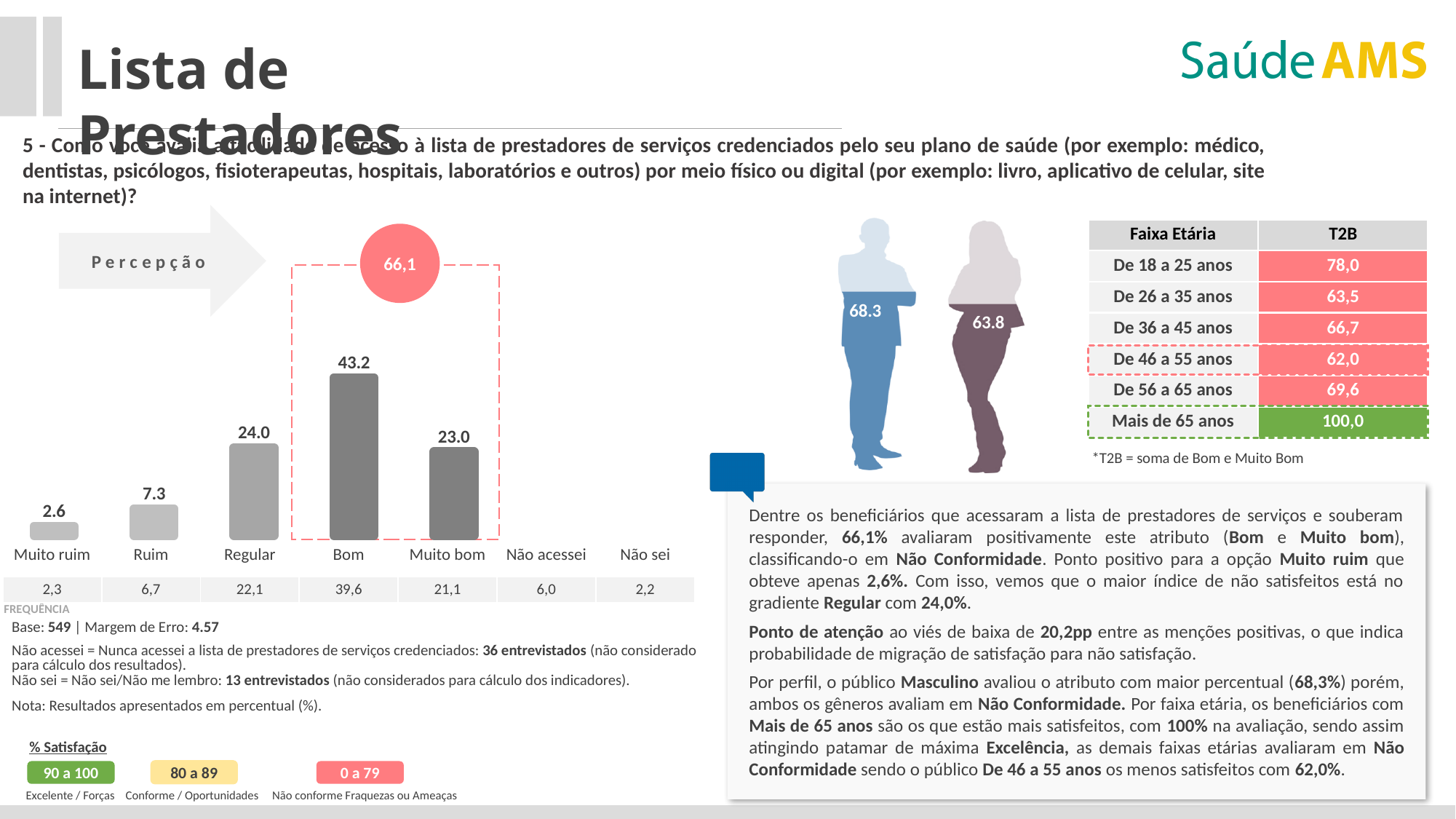
In the Percepção bar chart, what is the value for Bom? 43.2 In the Percepção bar chart, how many categories have a bar plotted? 5 In the Percepção bar chart, which category has the highest value? Bom In the Percepção bar chart, what is the value for Muito ruim? 2.6 In the Percepção bar chart, what is the value for Ruim? 7.3 What value is shown in the pink circle above the dashed box around Bom and Muito bom in the Percepção chart? 66,1 What kind of chart is used to show the Percepção results? bar chart In the Percepção bar chart, what is the difference between the values for Bom and Muito bom? 20.2 In the Percepção bar chart, what is the value for Regular? 24.0 In the Percepção bar chart, which category has the lowest plotted value? Muito ruim In the Percepção bar chart, do the values rise or fall from Muito ruim to Bom? rise In the Percepção bar chart, which is larger, the value for Regular or the value for Muito bom? Regular